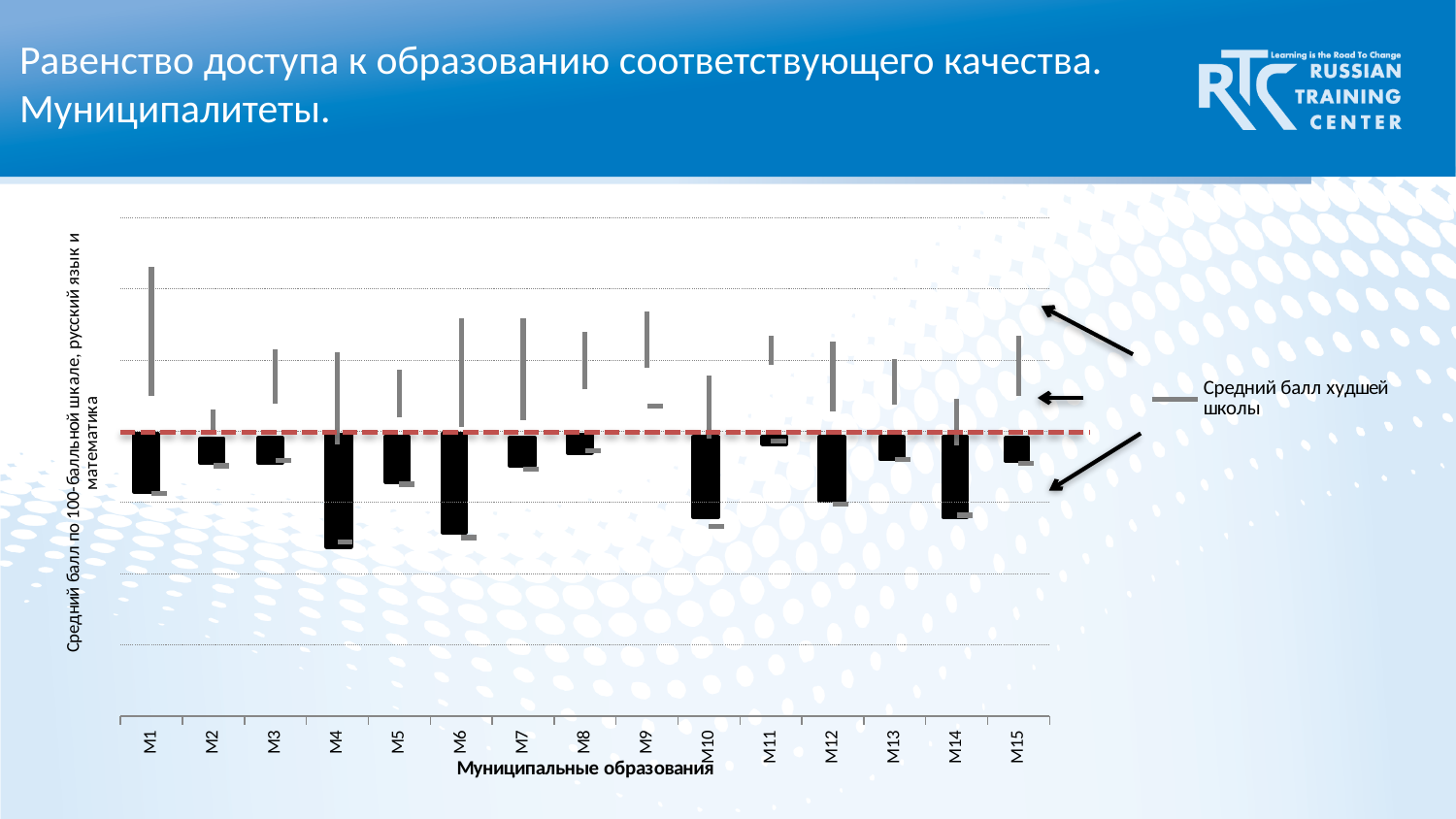
Whose gray bar above the red dashed line is taller, M1 or M9? M1 What is the title of the x axis of the chart? Муниципальные образования What is the title of the y axis of the chart? Средний балл по 100-балльной шкале, русский язык и математика Which municipality has the shortest gray bar above the red dashed line? M9 How many municipalities are shown along the x axis of the chart? 15 Whose black bar extends further below the red dashed line, M6 or M8? M6 Which municipality has the black bar that extends furthest below the red dashed line? M4 Which municipality has the shortest black bar below the red dashed line? M11 Whose black bar extends further below the red dashed line, M4 or M2? M4 Which municipality has the tallest gray bar above the red dashed line? M1 What kind of chart is shown on the slide? bar chart